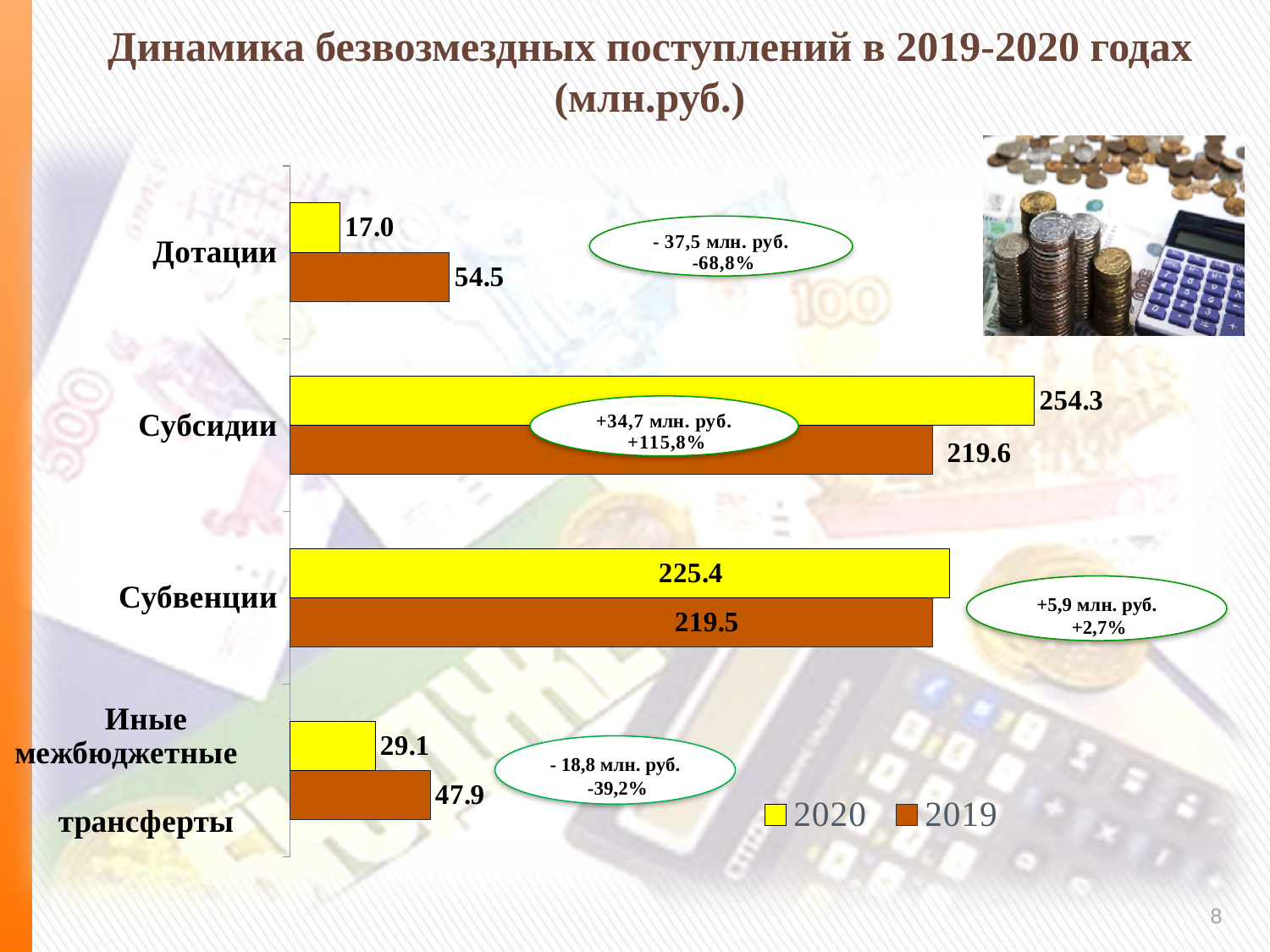
Which colour represents the 2020 series in the chart? Yellow How many categories are shown in the chart? 4 What is the value for Иные межбюджетные трансферты in 2019? 47.9 What is the difference between the 2019 and 2020 values for Дотации? 37.5 Which category has the lowest value in 2019? Иные межбюджетные трансферты What is the value for Субсидии in 2019? 219.6 What kind of chart is shown on the slide? Bar chart How many series does the legend list? 2 Which category has the highest value in 2020? Субсидии What is the value for Субвенции in 2020? 225.4 What is the value for Дотации in 2020? 17.0 Which is larger for Иные межбюджетные трансферты: the 2020 value or the 2019 value? 2019